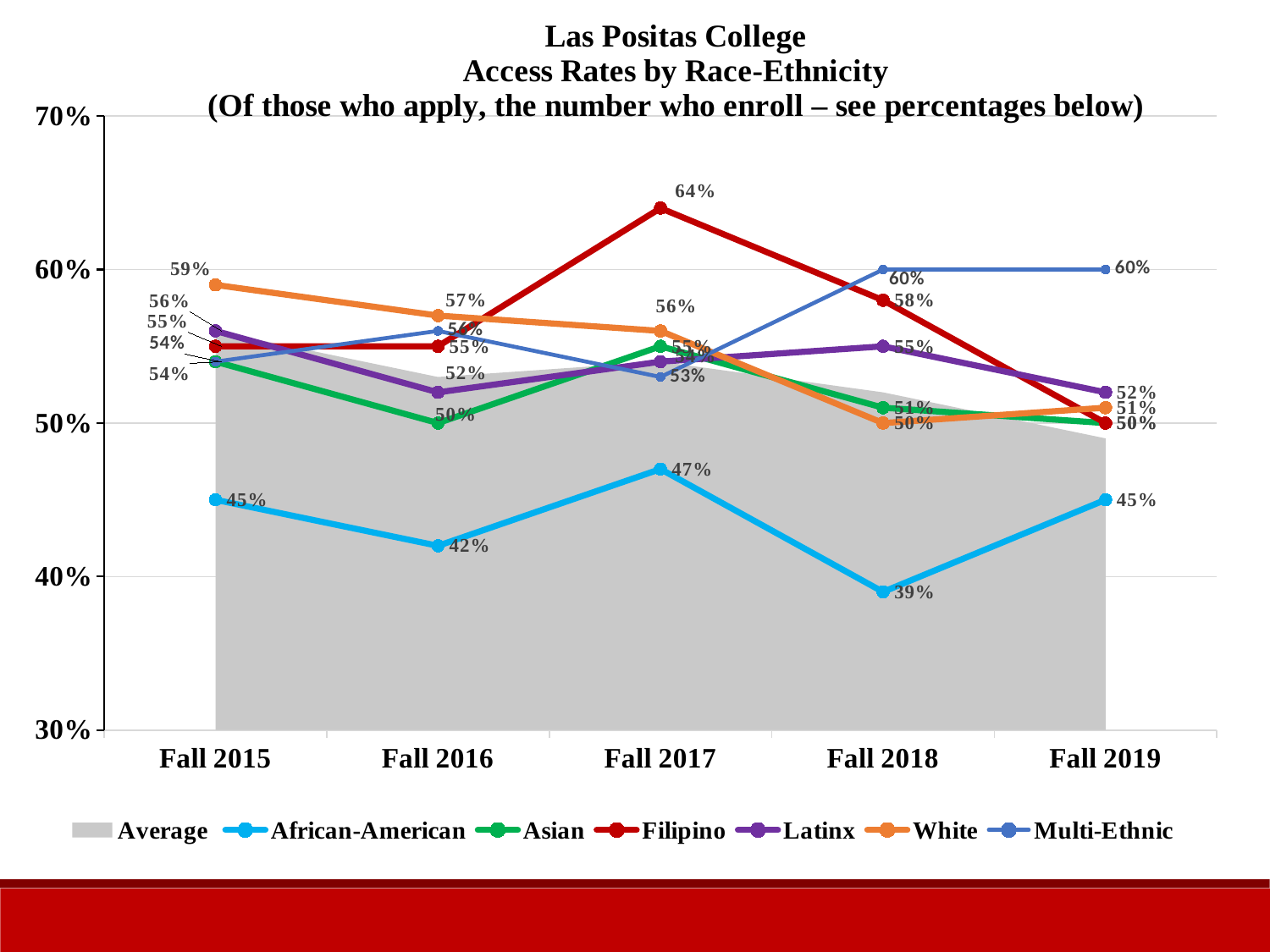
Is the Average access rate in Fall 2015 greater or less than 50%? greater What is the access rate for Multi-Ethnic students in Fall 2019? 60% How many series does the legend list? 7 Which race-ethnicity group has the lowest access rate in Fall 2018? African-American What is the access rate for White students in Fall 2015? 59% How many terms are shown on the x axis? 5 What is the access rate for African-American students in Fall 2018? 39% What is the access rate for Filipino students in Fall 2017? 64% In Fall 2015, which is larger: the access rate for White students or for African-American students? White Which race-ethnicity group has the highest access rate in Fall 2017? Filipino What is the difference between the Filipino and African-American access rates in Fall 2017? 17 percentage points Does the African-American access rate rise or fall from Fall 2017 to Fall 2018? fall